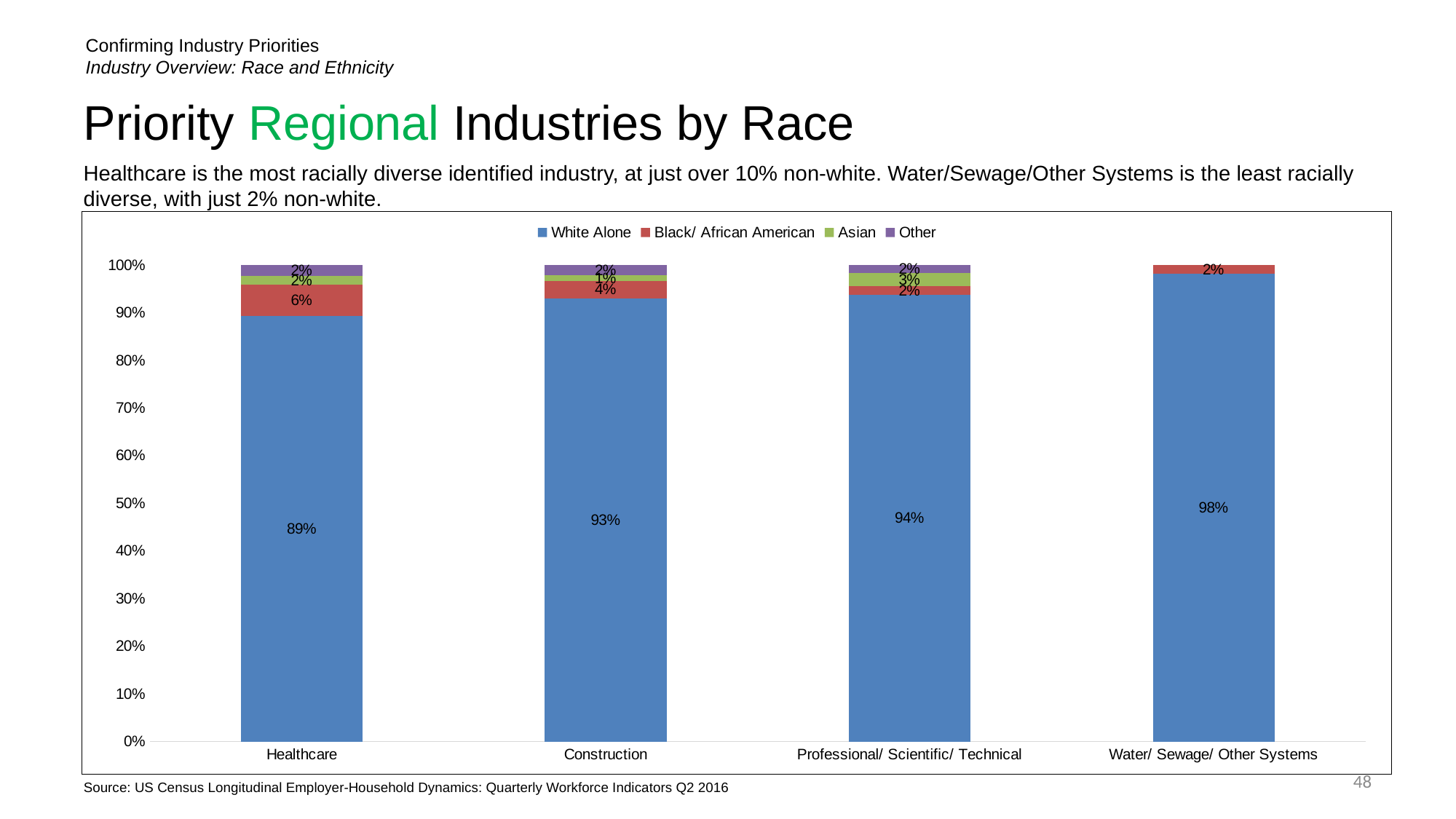
Which industry has the highest White Alone share? Water/ Sewage/ Other Systems What is the Asian share for Professional/ Scientific/ Technical? 3% Which industry has the lowest White Alone share? Healthcare What kind of chart is shown on the slide? Stacked bar chart What is the White Alone share for Water/ Sewage/ Other Systems? 98% What is the difference between the White Alone share for Water/ Sewage/ Other Systems and for Healthcare? 9% How many series does the legend list? 4 What is the White Alone share for Healthcare? 89% Which series is shown in blue in the legend? White Alone What is the Black/ African American share for Construction? 4% How many industries are shown on the x axis? 4 Which is larger, the Black/ African American share for Healthcare or for Construction? Healthcare